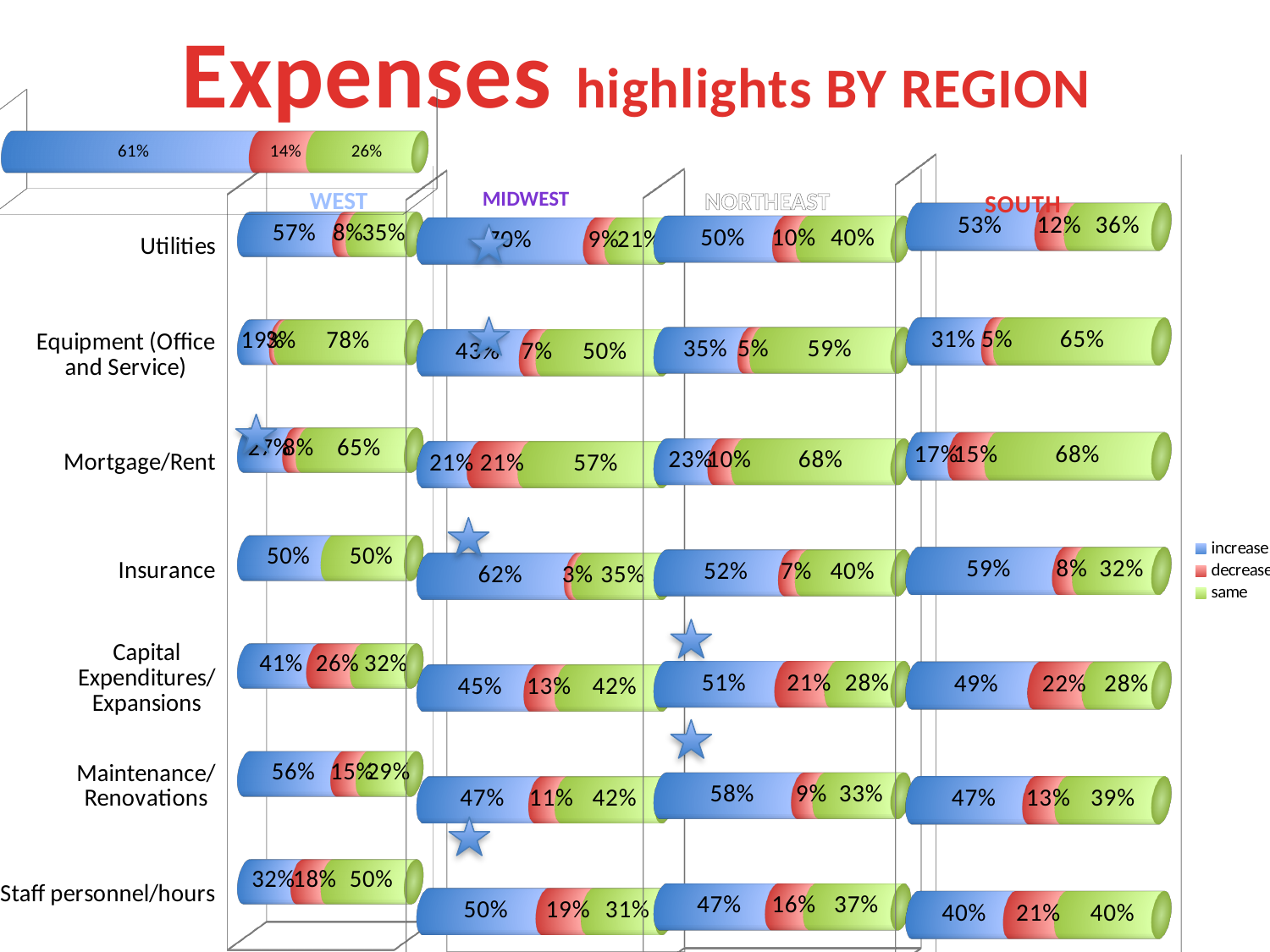
What kind of chart is used on the slide? Stacked bar chart In the WEST chart, what is the 'increase' value for Capital Expenditures/Expansions? 41% In the MIDWEST chart, what is the difference between the 'increase' value for Insurance and the 'increase' value for Capital Expenditures/Expansions? 17% In the NORTHEAST chart, which category has the lowest 'decrease' value? Equipment (Office and Service) How many series does the legend list? 3 Which colour represents 'decrease' in the legend? Red In the SOUTH chart, which category has the highest 'same' value? Mortgage/Rent In the SOUTH chart, what percentage of respondents reported an increase in Utilities? 53% How many expense categories are listed on the slide? 7 In the MIDWEST chart, what is the 'decrease' value for Staff personnel/hours? 19% In the SOUTH chart, which is larger for Maintenance/Renovations: the 'increase' value or the 'same' value? increase In the NORTHEAST chart, what is the 'same' value for Mortgage/Rent? 68%